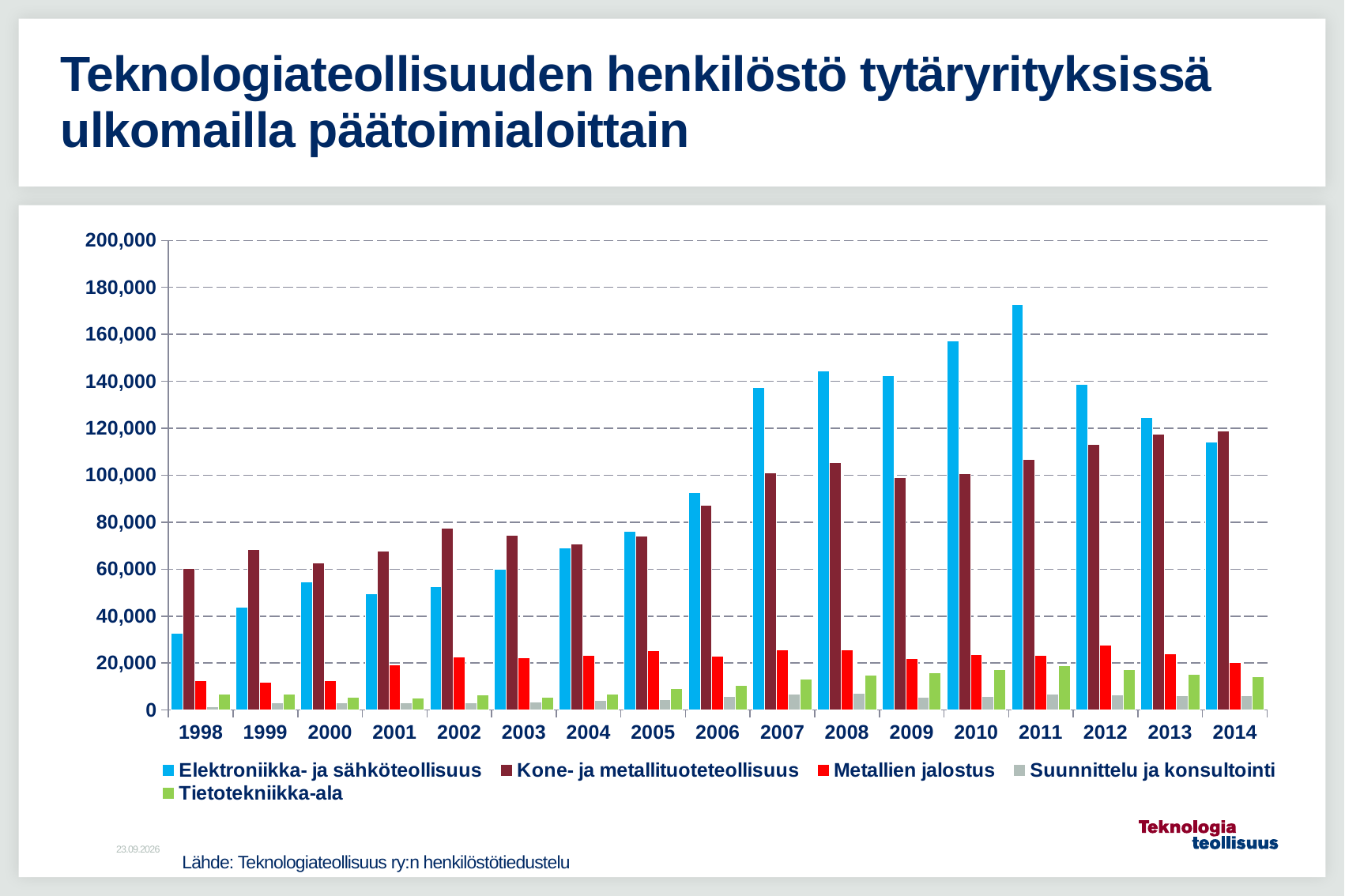
In which year is the value for Elektroniikka- ja sähköteollisuus lowest? 1998 How many series does the legend list? 5 In which year is the value for Elektroniikka- ja sähköteollisuus highest? 2011 Is the value for Metallien jalostus in 2012 greater or less than 20,000? greater Is the value for Elektroniikka- ja sähköteollisuus in 2011 greater or less than 160,000? greater What kind of chart is shown on the slide? bar chart Which series has the lowest value in 2014? Suunnittelu ja konsultointi Is the value for Elektroniikka- ja sähköteollisuus in 1998 greater or less than 40,000? less In 2013, which is larger: Elektroniikka- ja sähköteollisuus or Kone- ja metallituoteteollisuus? Elektroniikka- ja sähköteollisuus How many years are shown on the x axis? 17 Do the values for Elektroniikka- ja sähköteollisuus rise or fall from 2011 to 2014? fall